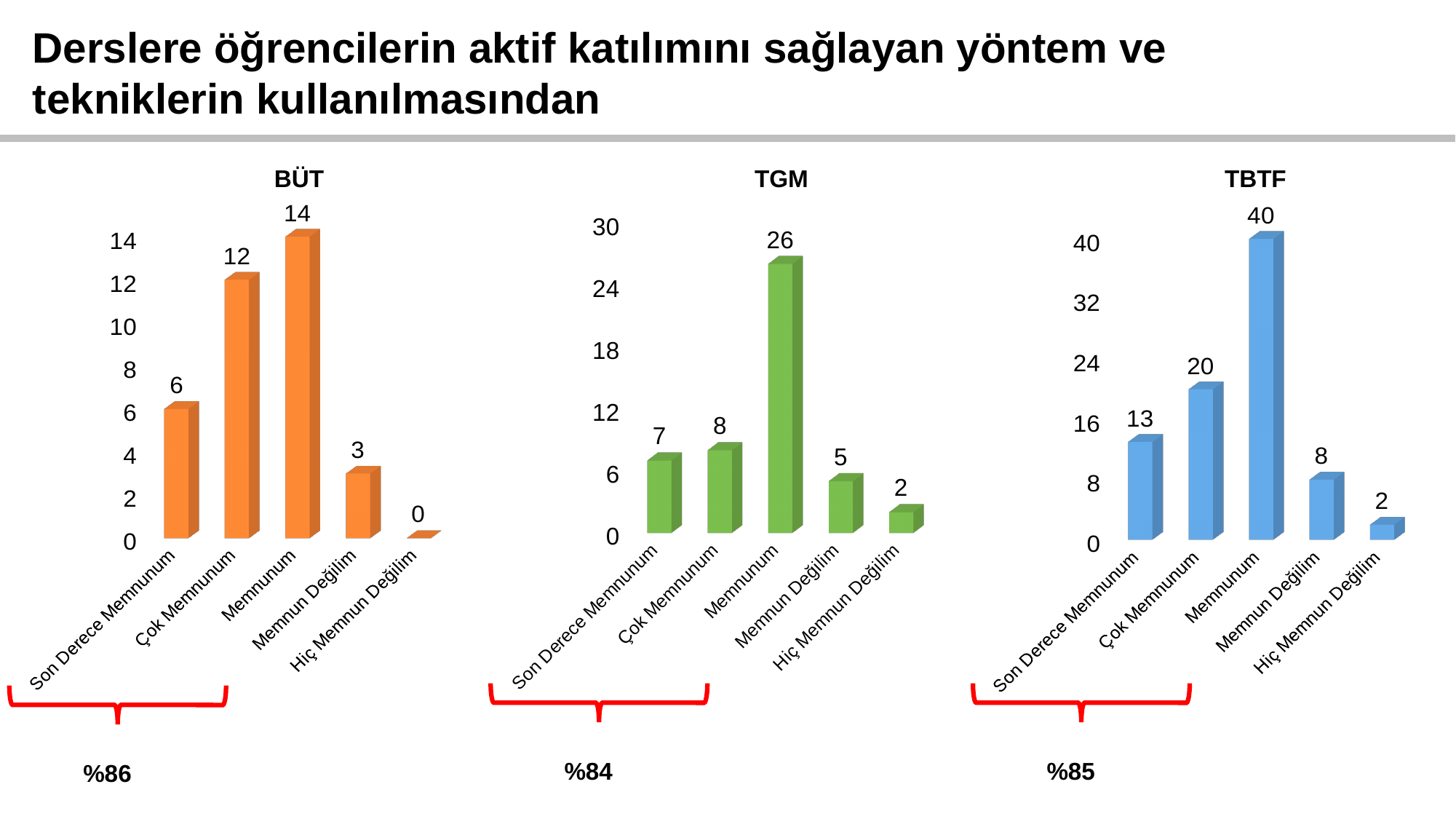
In the TBTF chart, what is the value for Çok Memnunum? 20 In the BÜT chart, which category has the lowest value? Hiç Memnun Değilim In the TGM chart, what is the value for Hiç Memnun Değilim? 2 How many categories does the TGM chart show? 5 In the TGM chart, what is the difference between Memnunum and Çok Memnunum? 18 In the BÜT chart, which is larger: Son Derece Memnunum or Çok Memnunum? Çok Memnunum In the TBTF chart, what is the difference between Son Derece Memnunum and Memnun Değilim? 5 In the BÜT chart, what is the value for Memnunum? 14 In the TBTF chart, which category has the highest value? Memnunum What kind of chart is the TBTF chart? bar chart What colour are the bars in the TGM chart? green In the TGM chart, is the value for Memnunum greater or less than 24? greater